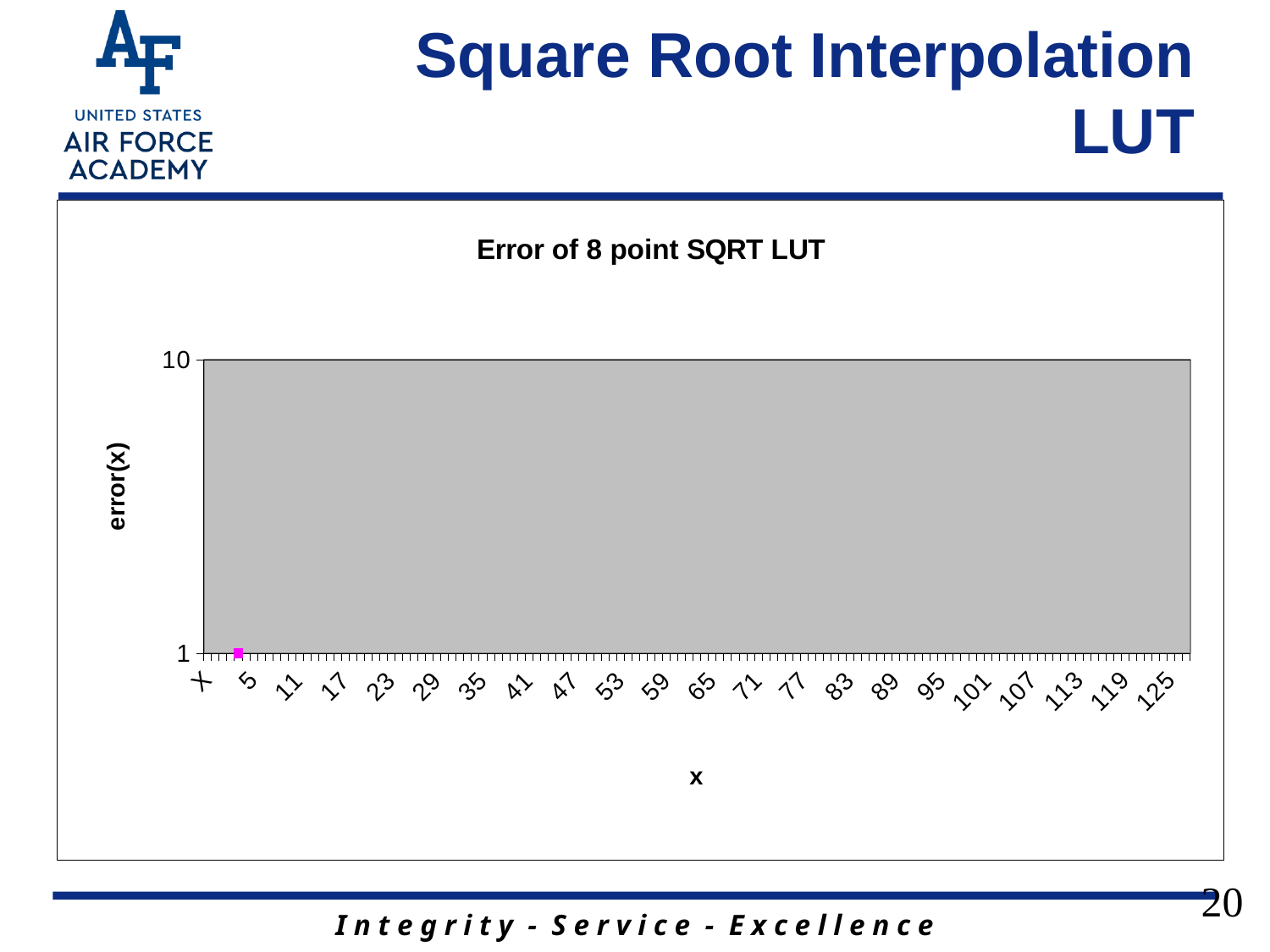
Is the plotted value near x = 5 greater or less than 10? less What is the title of the chart? Error of 8 point SQRT LUT What label is shown on the vertical axis of the chart? error(x)